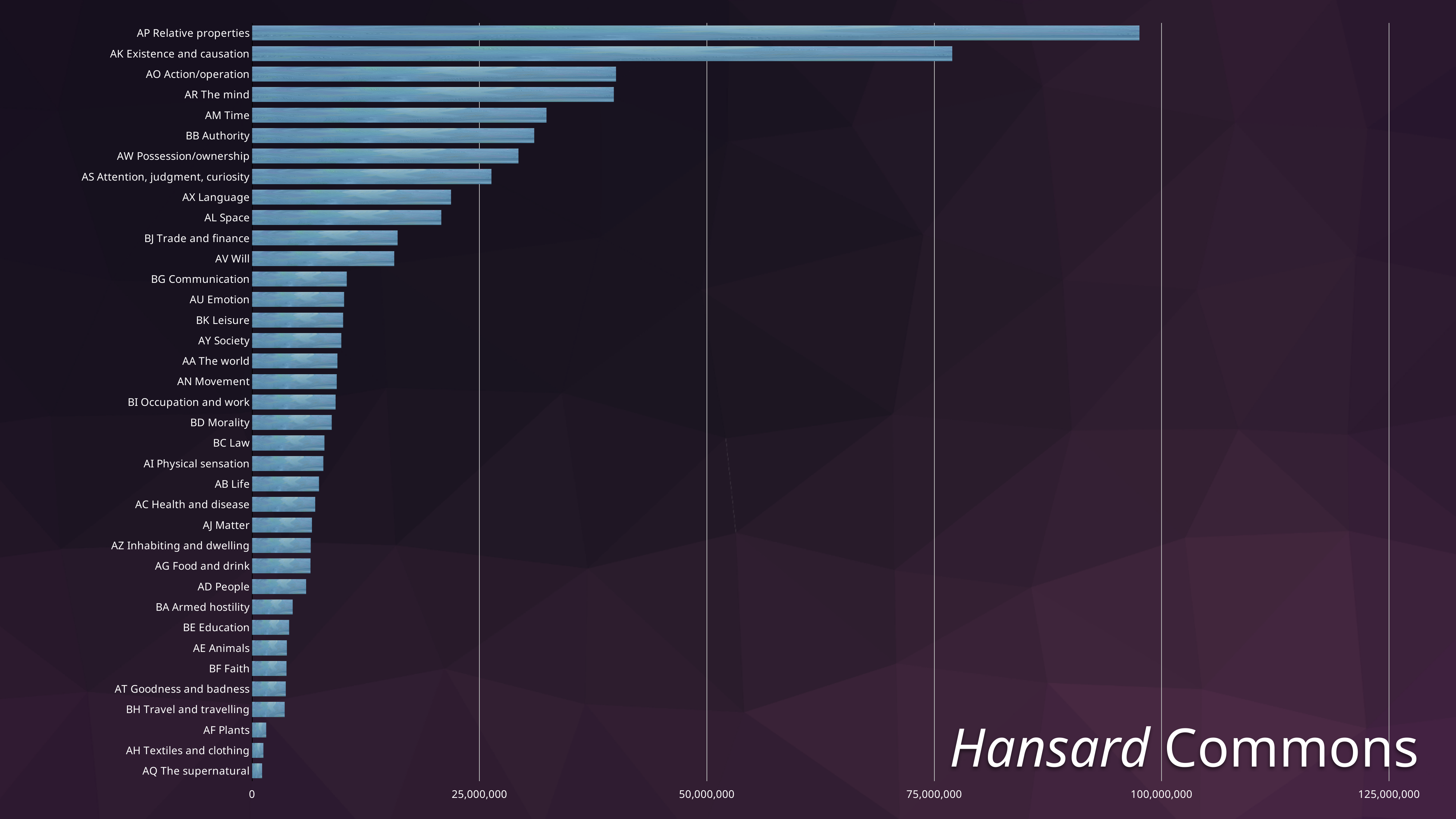
Is the value for AX Language greater or less than 25,000,000? less Which is larger, the value for AP Relative properties or AK Existence and causation? AP Relative properties Which is larger, the value for AO Action/operation or AX Language? AO Action/operation What kind of chart is shown on the slide? bar chart Is the value for AP Relative properties greater or less than 75,000,000? greater What text is shown in large letters at the bottom right of the chart? Hansard Commons How many categories are plotted on the chart? 37 Is the value for AK Existence and causation greater or less than 100,000,000? less Do the bar values increase or decrease from the top of the chart to the bottom? decrease Which category has the highest value? AP Relative properties